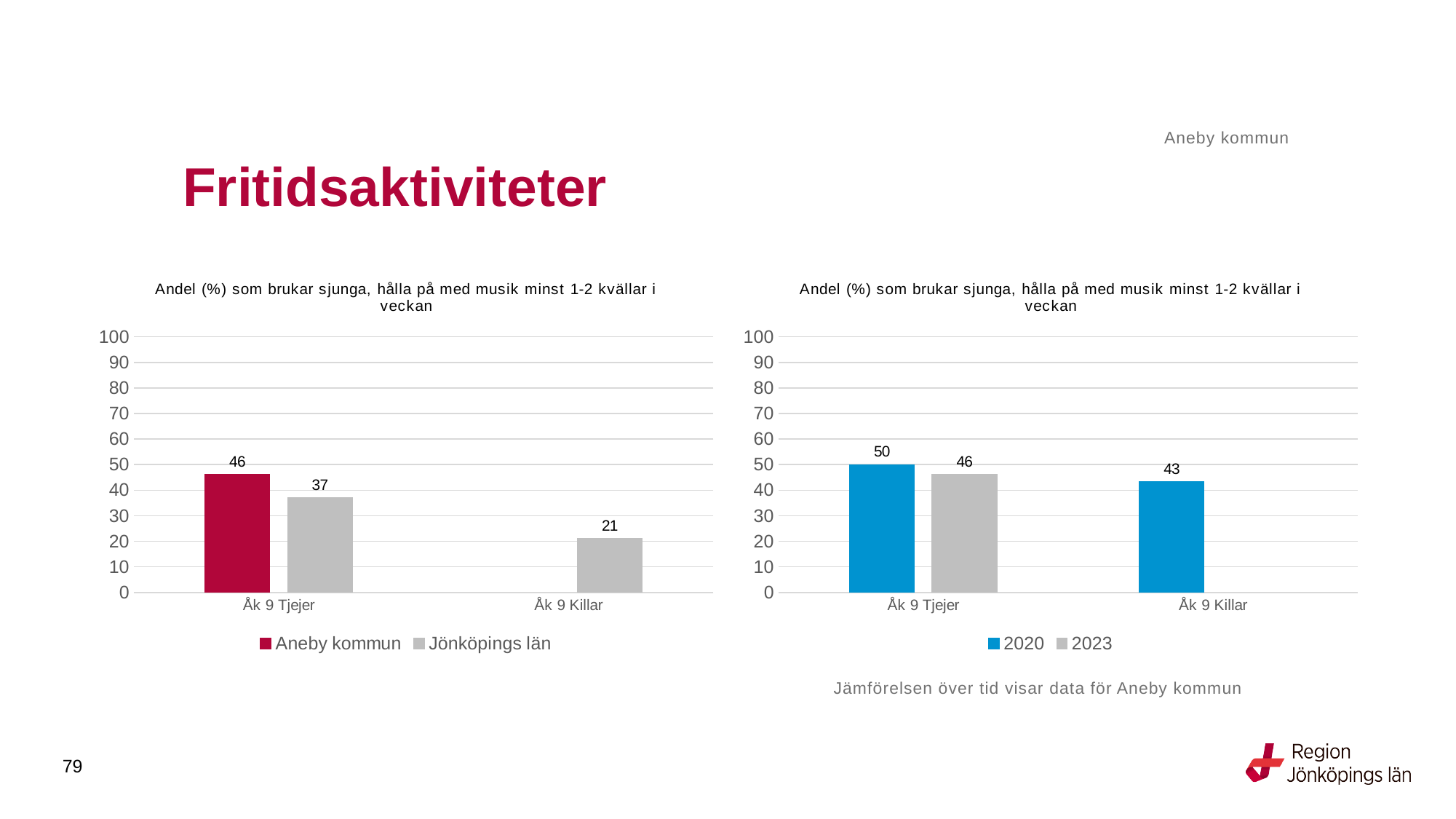
In the right chart, how many categories are shown on the x axis? 2 In the left chart, which series has the higher value for Åk 9 Tjejer, Aneby kommun or Jönköpings län? Aneby kommun In the left chart, what is the value for Jönköpings län for Åk 9 Killar? 21 In the right chart, what is the difference between 2020 and 2023 for Åk 9 Tjejer? 4 In the right chart, which category has the highest value for 2020? Åk 9 Tjejer What kind of chart is the left chart? Bar chart In the right chart, what is the value for 2020 for Åk 9 Killar? 43 In the right chart, what is the value for 2023 for Åk 9 Tjejer? 46 In the right chart, which years does the legend list? 2020 and 2023 In the left chart, what is the difference between Aneby kommun and Jönköpings län for Åk 9 Tjejer? 9 In the left chart, how many series does the legend list? 2 In the left chart, what is the value for Aneby kommun for Åk 9 Tjejer? 46